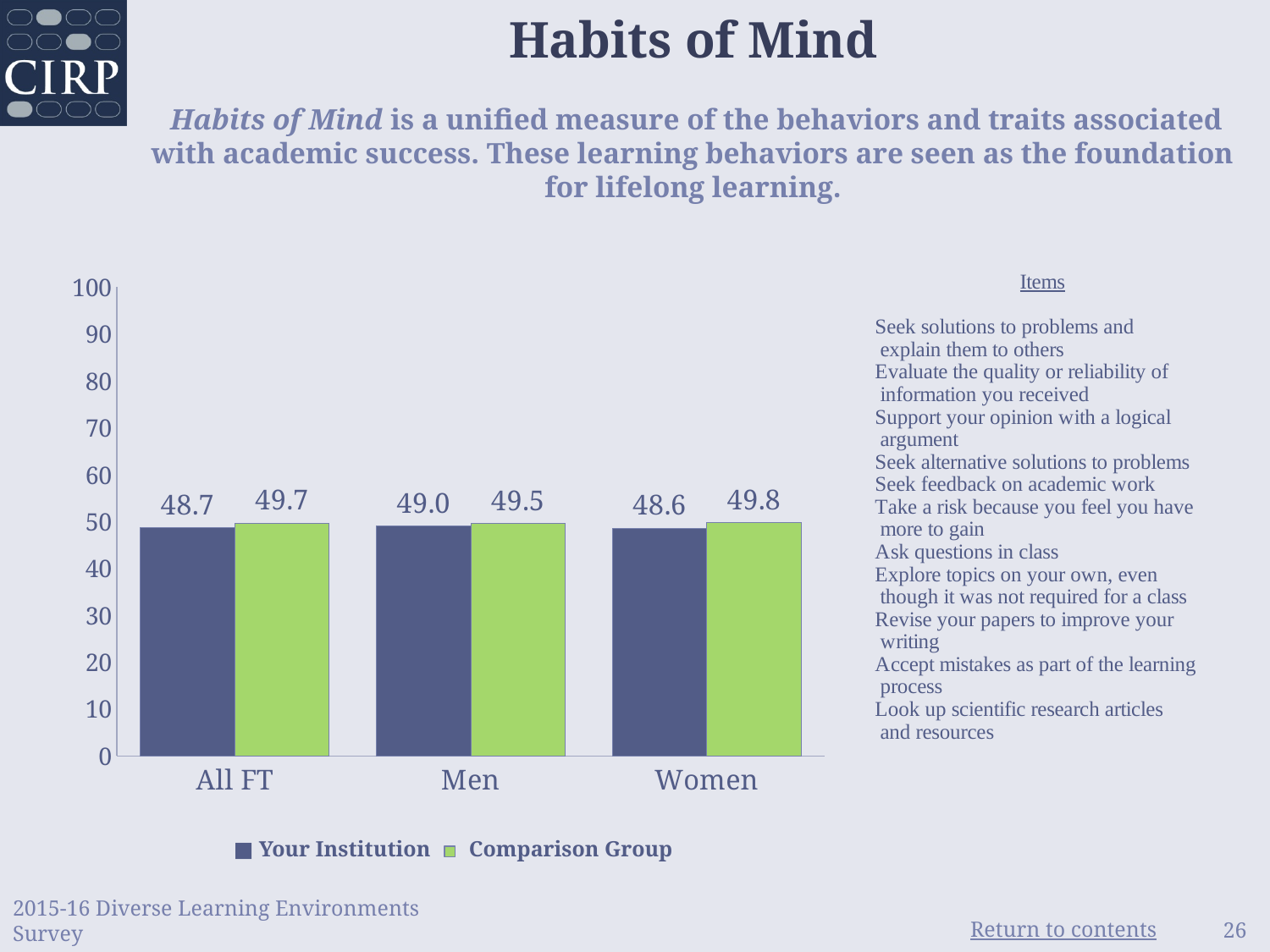
What is the value for Comparison Group for Women? 49.8 Which is larger for Men: Your Institution or Comparison Group? Comparison Group What kind of chart is shown on the slide? bar chart Is the value for Your Institution for All FT greater or less than 50? less Which category has the lowest Your Institution value? Women How many categories are shown on the x axis? 3 What is the difference between the Comparison Group and Your Institution values for Women? 1.2 What is the value for Comparison Group for All FT? 49.7 Which category has the highest Comparison Group value? Women What is the value for Your Institution for All FT? 48.7 What is the value for Your Institution for Men? 49.0 How many series does the legend list? 2